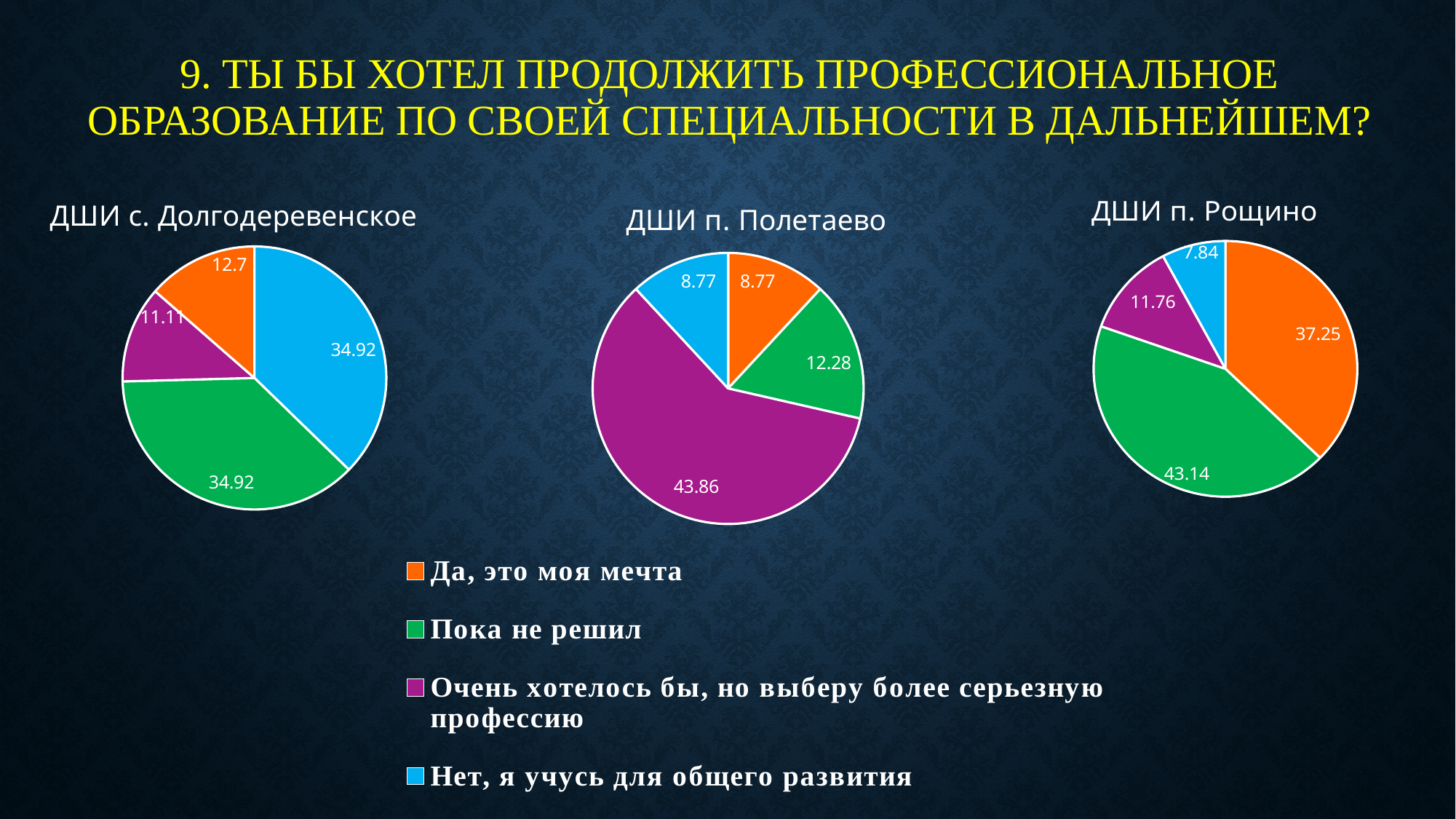
In the chart titled "ДШИ п. Рощино", what is the difference between the values for "Пока не решил" and "Да, это моя мечта"? 5.89 What type of chart is the chart titled "ДШИ с. Долгодеревенское"? Pie chart In the chart titled "ДШИ с. Долгодеревенское", which is larger: the value for "Да, это моя мечта" or the value for "Очень хотелось бы, но выберу более серьезную профессию"? Да, это моя мечта In the chart titled "ДШИ п. Рощино", which category has the largest slice? Пока не решил In the chart titled "ДШИ п. Полетаево", what is the value for "Очень хотелось бы, но выберу более серьезную профессию"? 43.86 In the chart titled "ДШИ п. Полетаево", what is the difference between the values for "Очень хотелось бы, но выберу более серьезную профессию" and "Пока не решил"? 31.58 In the chart titled "ДШИ с. Долгодеревенское", what is the value for "Очень хотелось бы, но выберу более серьезную профессию"? 11.11 In the chart titled "ДШИ п. Рощино", what is the value for "Да, это моя мечта"? 37.25 How many slices does the chart titled "ДШИ п. Полетаево" have? 4 In the chart titled "ДШИ с. Долгодеревенское", which category has the smallest slice? Очень хотелось бы, но выберу более серьезную профессию In the chart titled "ДШИ п. Полетаево", which category has the largest slice? Очень хотелось бы, но выберу более серьезную профессию In the chart titled "ДШИ п. Рощино", what is the value for "Нет, я учусь для общего развития"? 7.84